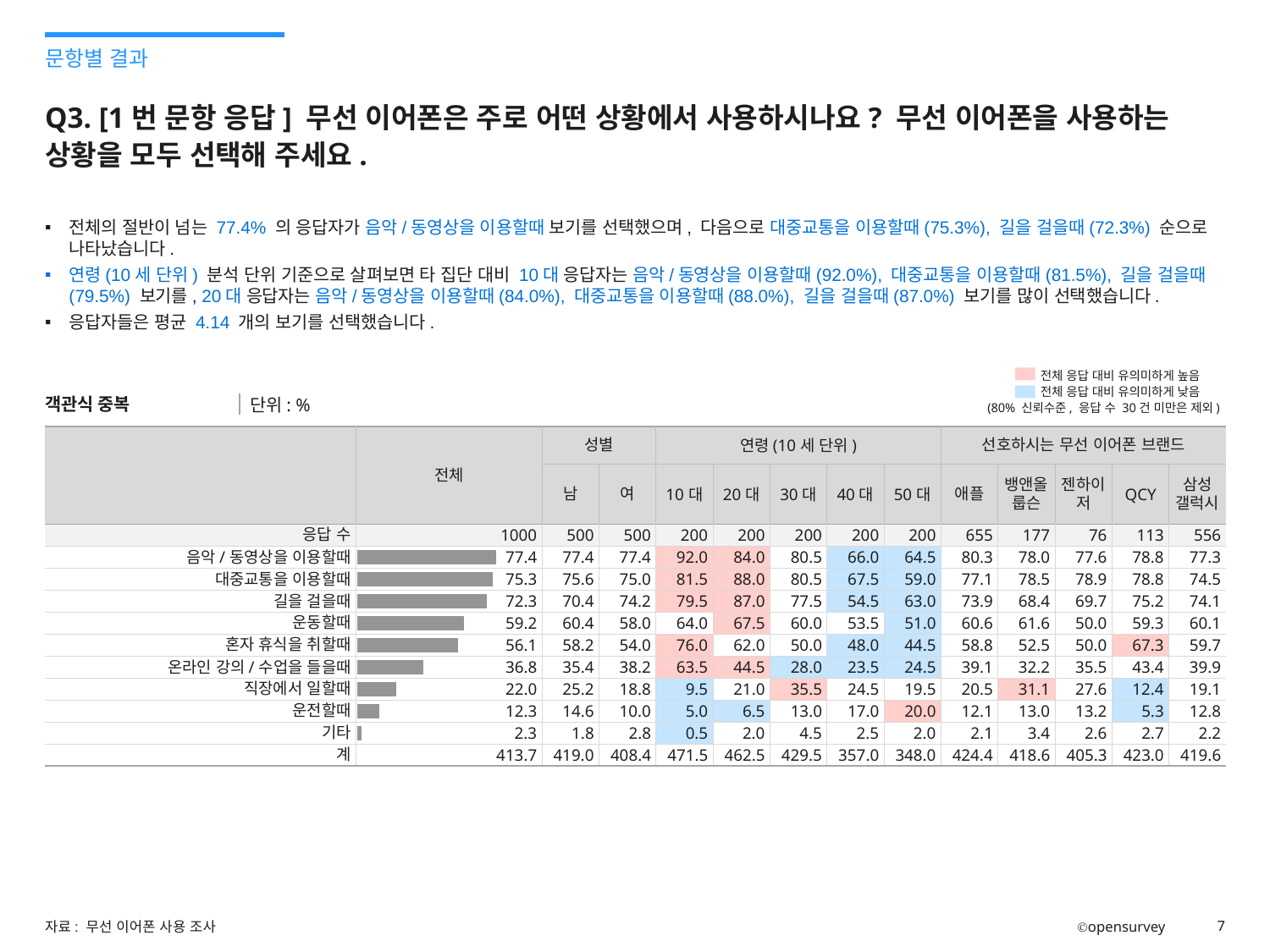
Which category has the lowest value in the 전체 bar chart? 기타 What unit is stated for the values in the chart? % Which category has the highest value in the 전체 bar chart? 음악 / 동영상을 이용할때 What kind of chart is shown in the 전체 column? bar chart Do the values in the 전체 bar chart rise or fall from the top category to the bottom category? fall What is the value for 운동할때 in the 전체 bar chart? 59.2 What is the value for 운전할때 in the 전체 bar chart? 12.3 In the 전체 bar chart, which is larger: 온라인 강의 / 수업을 들을때 or 직장에서 일할때? 온라인 강의 / 수업을 들을때 What is the value for 음악 / 동영상을 이용할때 in the 전체 bar chart? 77.4 How many categories are shown in the 전체 bar chart? 9 What is the difference between 대중교통을 이용할때 and 길을 걸을때 in the 전체 bar chart? 3.0 What is the difference between 운동할때 and 혼자 휴식을 취할때 in the 전체 bar chart? 3.1